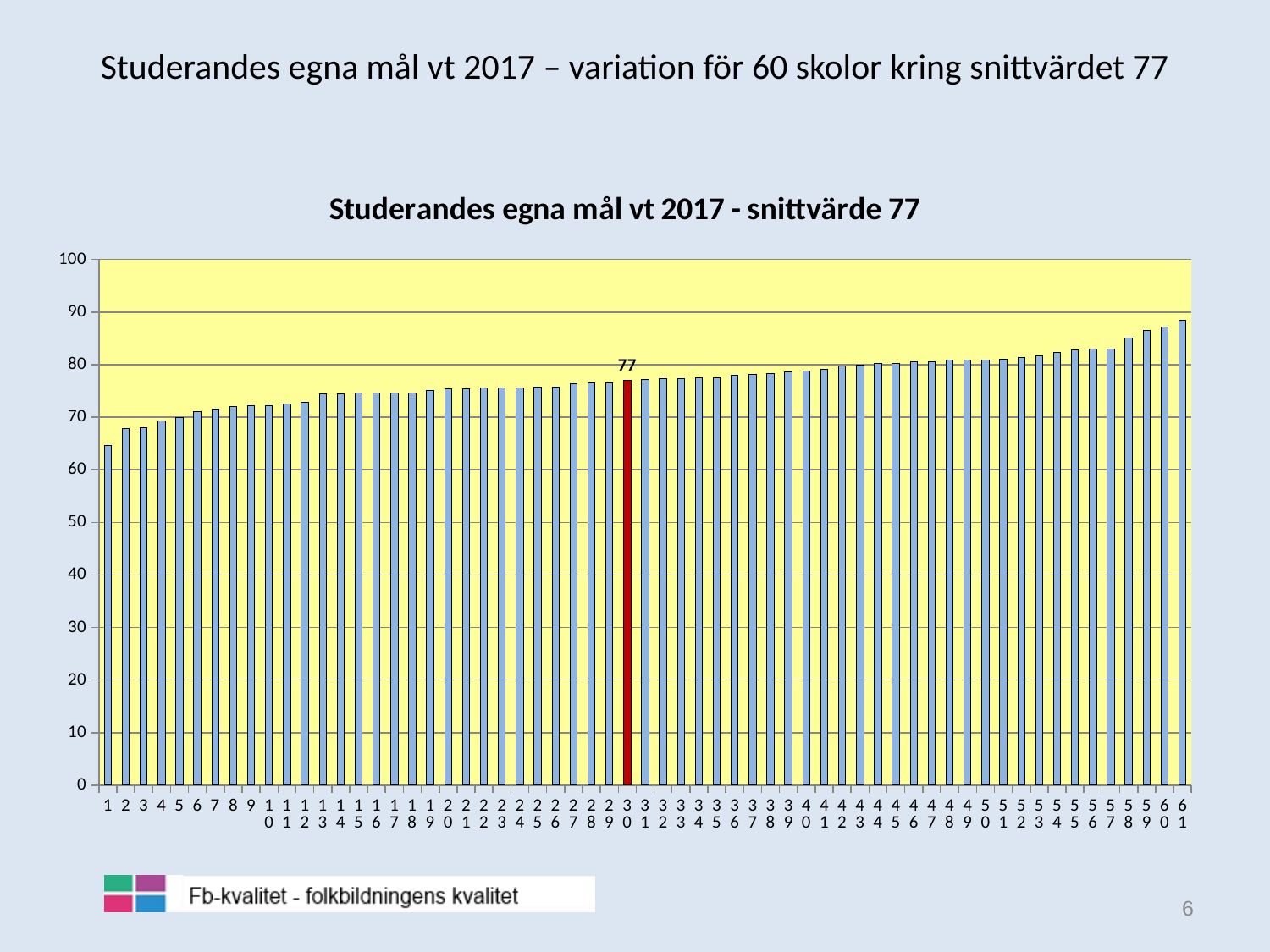
What value is printed on the red bar at position 30? 77 How many bars (schools) are plotted in the chart? 61 What is the title of the chart? Studerandes egna mål vt 2017 - snittvärde 77 Is the value for bar 1 greater or less than 70? less What kind of chart is shown on the slide? bar chart What colour is the bar at position 30, which is highlighted differently from the others? red Do the bar values rise or fall from left to right along the x axis? rise Which bar has the highest value? 61 Which is larger, the value for bar 1 or the value for bar 61? bar 61 Is the value for bar 61 greater or less than 80? greater Is the value for bar 61 greater or less than 90? less Which bar has the lowest value? 1